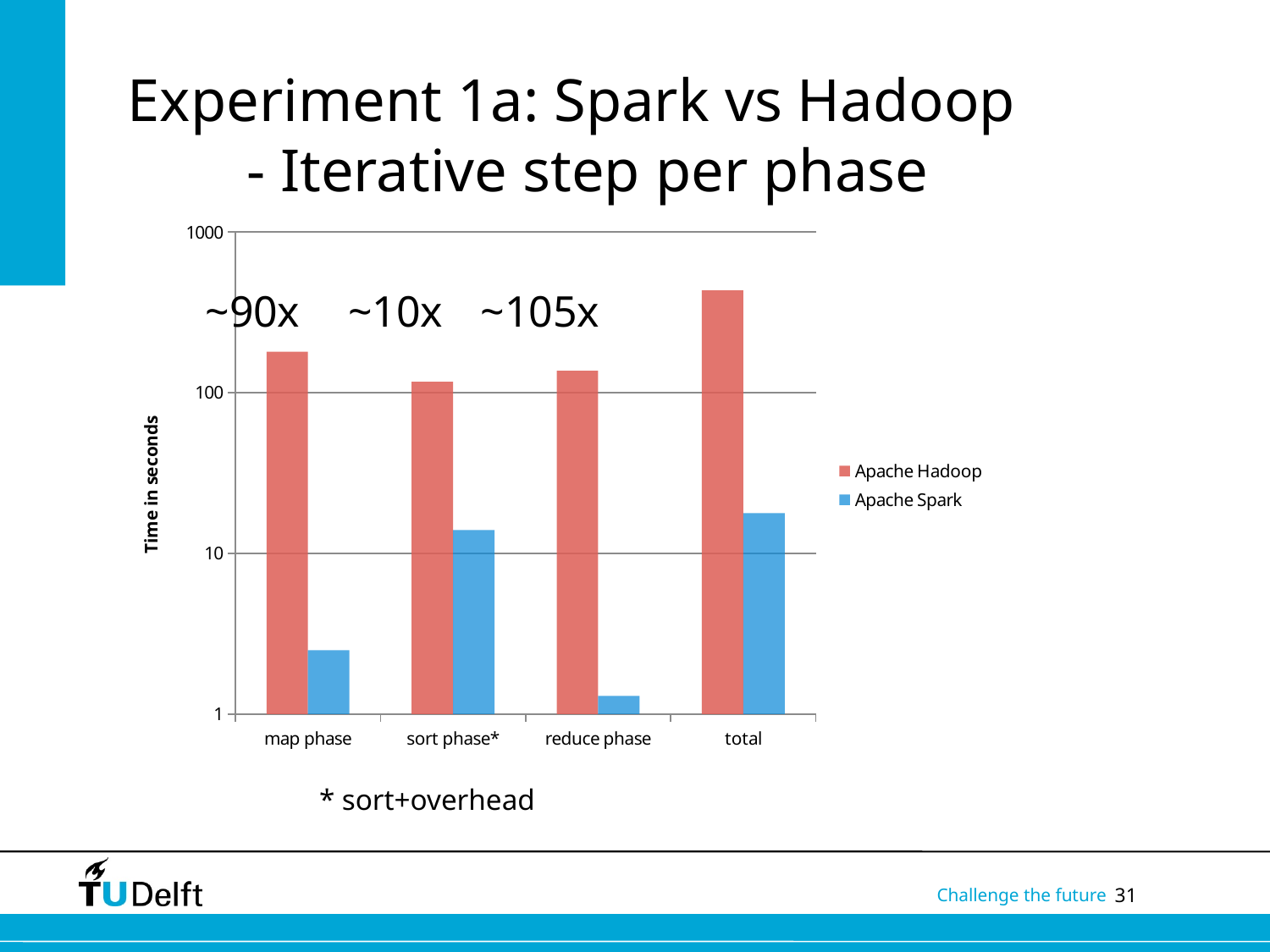
Which category has the highest value for Apache Hadoop? total Is the value for Apache Spark in the sort phase* greater or less than 10? greater Is the value for Apache Spark in the map phase greater or less than 10? less Is the value for Apache Hadoop for total greater or less than 1000? less Which is larger in the reduce phase, Apache Hadoop or Apache Spark? Apache Hadoop What kind of chart is shown on the slide? bar chart How many categories are shown on the x axis? 4 How many series does the legend list? 2 Which category has the lowest value for Apache Spark? reduce phase What is the title of the y axis? Time in seconds Which colour represents Apache Spark in the legend? blue